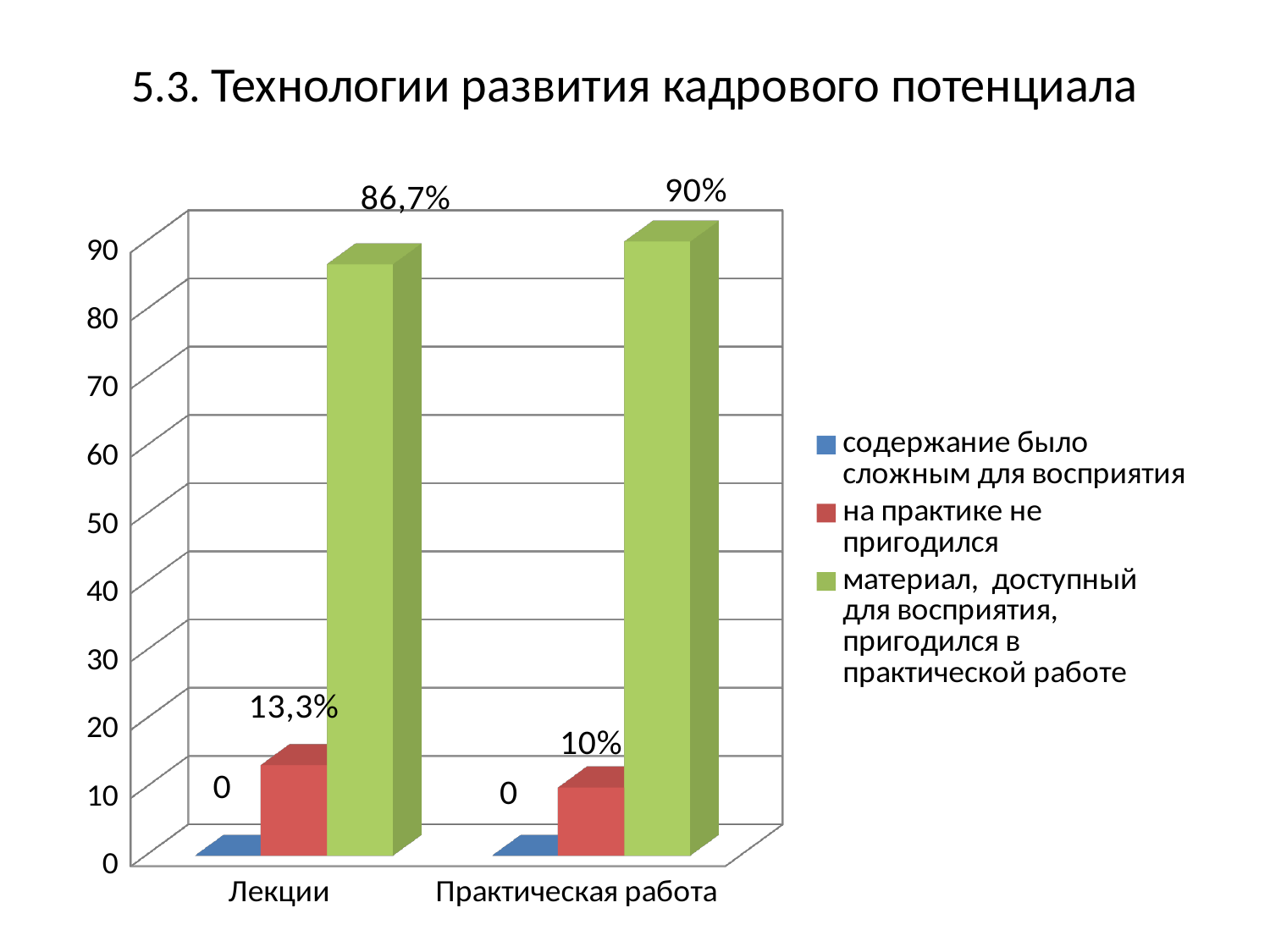
What is the value for "на практике не пригодился" for Практическая работа? 10% Which category has the higher value for "на практике не пригодился", Лекции or Практическая работа? Лекции What kind of chart is shown on the slide? bar chart What is the value for "материал, доступный для восприятия, пригодился в практической работе" for Лекции? 86,7% What is the value for "на практике не пригодился" for Лекции? 13,3% Which category has the higher value for "материал, доступный для восприятия, пригодился в практической работе"? Практическая работа How many series does the legend list? 3 What colour are the bars for "на практике не пригодился"? red What is the value for "содержание было сложным для восприятия" for Лекции? 0 How many categories are shown on the x axis? 2 What is the value for "материал, доступный для восприятия, пригодился в практической работе" for Практическая работа? 90% Which series has the lowest value for Практическая работа? содержание было сложным для восприятия